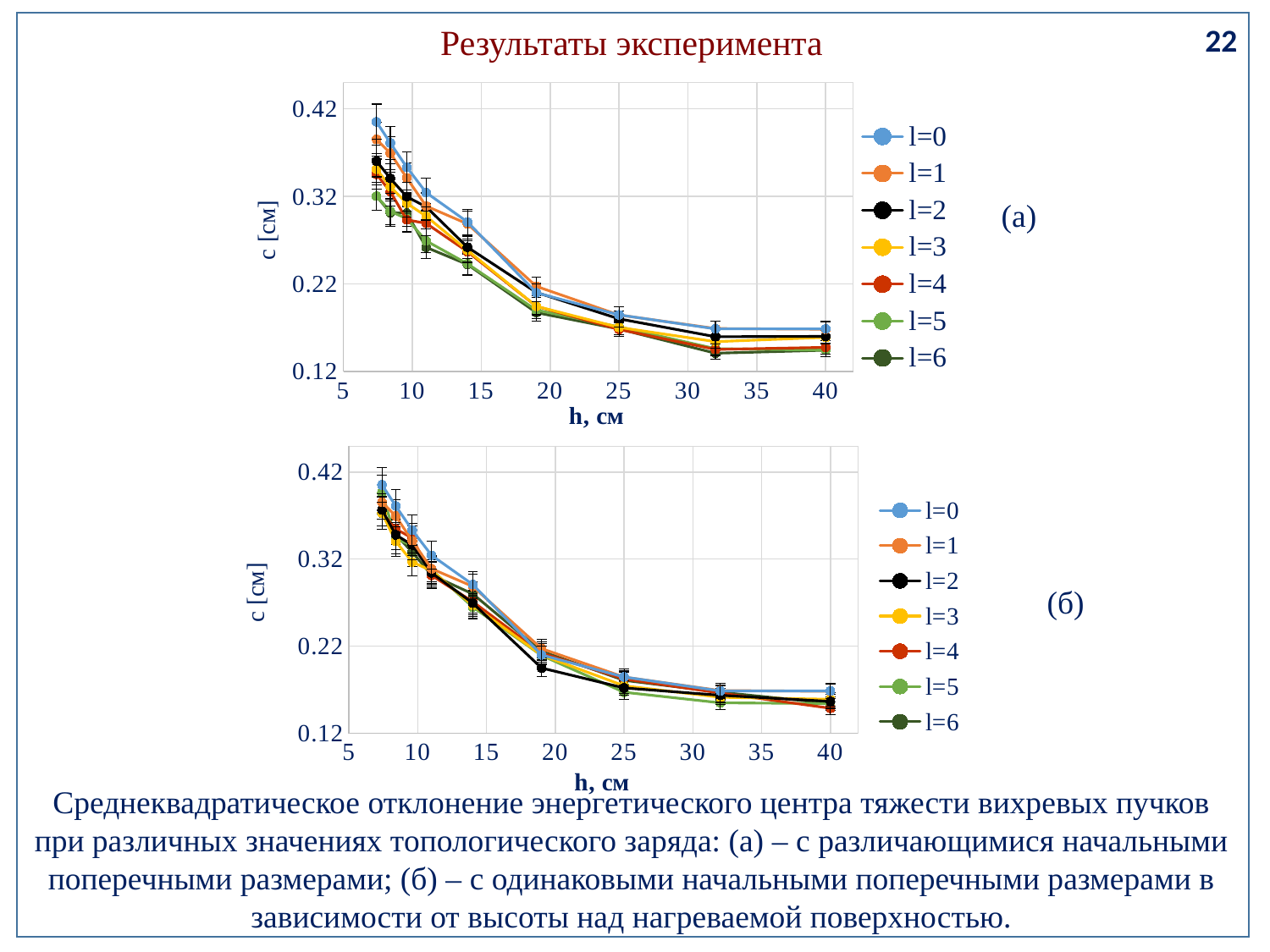
In chart (a), is the value for l=0 at h=40 greater or less than 0.22? less In chart (b), do the values of the l=2 series rise or fall as h increases? fall How many series does the legend of chart (a) list? 7 What is the label of the x axis of chart (a)? h, см In chart (a), do the values of the l=0 series rise or fall as h increases? fall What is the label of the y axis of chart (b)? c [см] In chart (a), is the value for l=0 at h=7 greater or less than 0.32? greater In chart (b), is the value for l=2 at h=19 greater or less than 0.22? less What kind of chart is chart (a)? line chart How many series does the legend of chart (b) list? 7